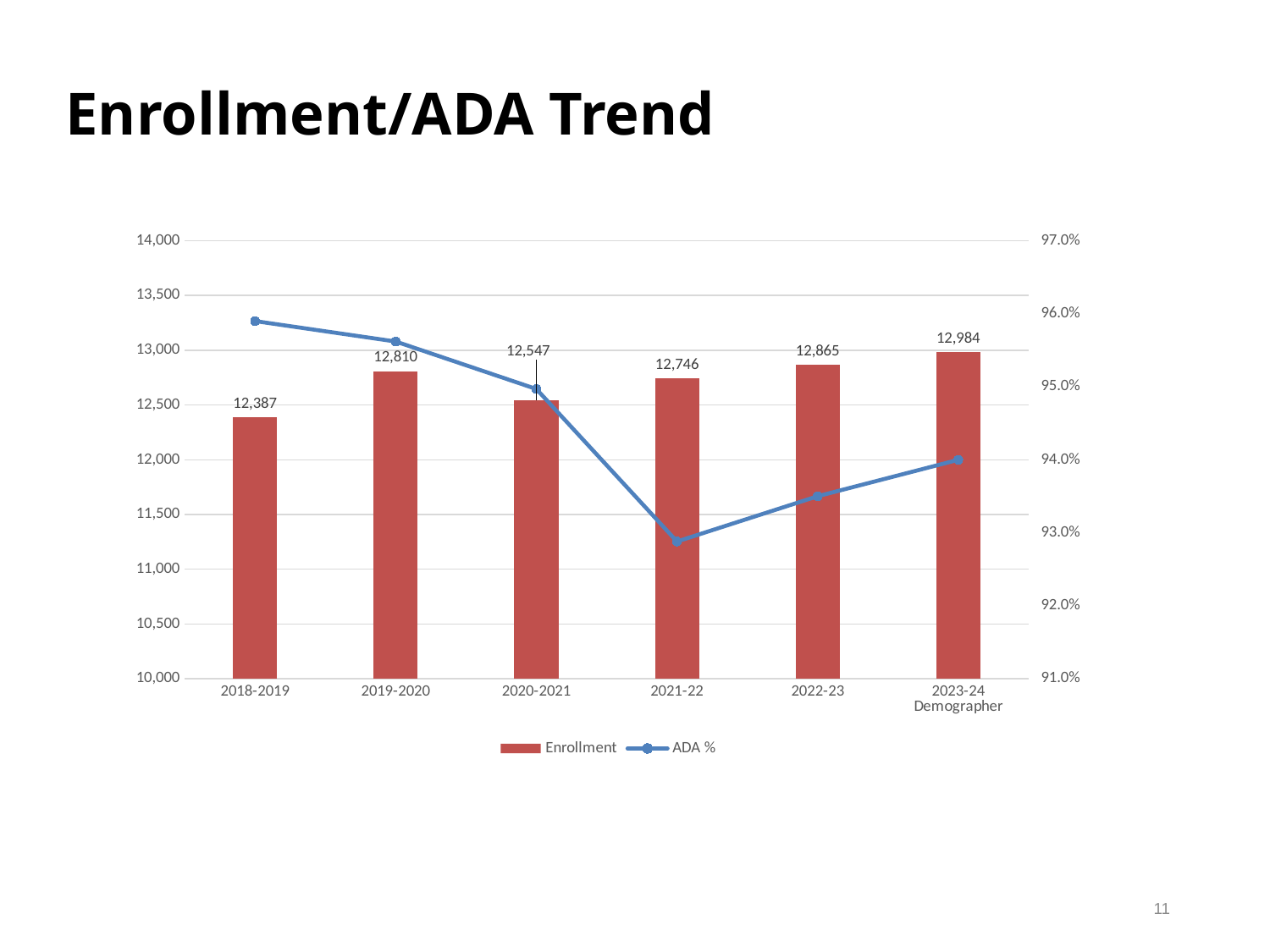
Which year has the lowest Enrollment? 2018-2019 How many series does the legend list? 2 How many years are shown on the x axis? 6 Which year has the larger Enrollment, 2019-2020 or 2020-2021? 2019-2020 Is the ADA % value for 2018-2019 greater or less than 95.0%? greater Is the ADA % value for 2021-22 greater or less than 94.0%? less What is the Enrollment value for 2018-2019? 12,387 What is the Enrollment value for 2023-24 Demographer? 12,984 Which year has the highest Enrollment? 2023-24 Demographer What is the Enrollment value for 2021-22? 12,746 In which year is the ADA % line at its lowest point? 2021-22 What is the difference in Enrollment between 2023-24 Demographer and 2018-2019? 597